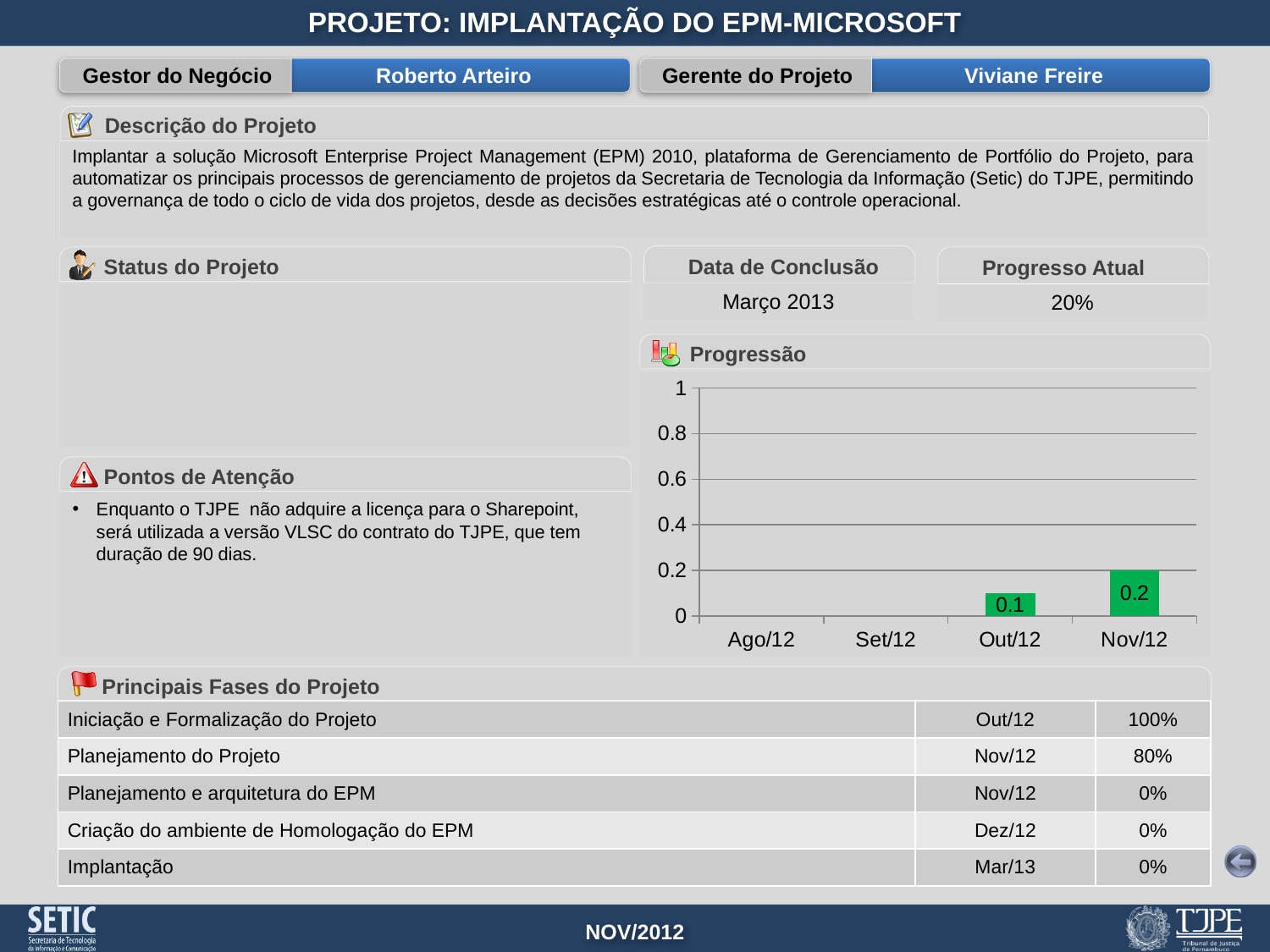
What is the value for Out/12 in the Progressão chart? 0.1 How many months are shown on the x axis of the Progressão chart? 4 Is the value for Nov/12 in the Progressão chart greater or less than 0.4? less What is the value for Nov/12 in the Progressão chart? 0.2 In the Progressão chart, which is larger: the value for Out/12 or the value for Nov/12? Nov/12 Is the value for Out/12 in the Progressão chart greater or less than 0.2? less What is the difference between the values for Nov/12 and Out/12 in the Progressão chart? 0.1 What is the title of the chart on the slide? Progressão Do the values in the Progressão chart rise or fall from Out/12 to Nov/12? rise Which month has the highest value in the Progressão chart? Nov/12 What colour are the bars in the Progressão chart? green What kind of chart is the Progressão chart? bar chart